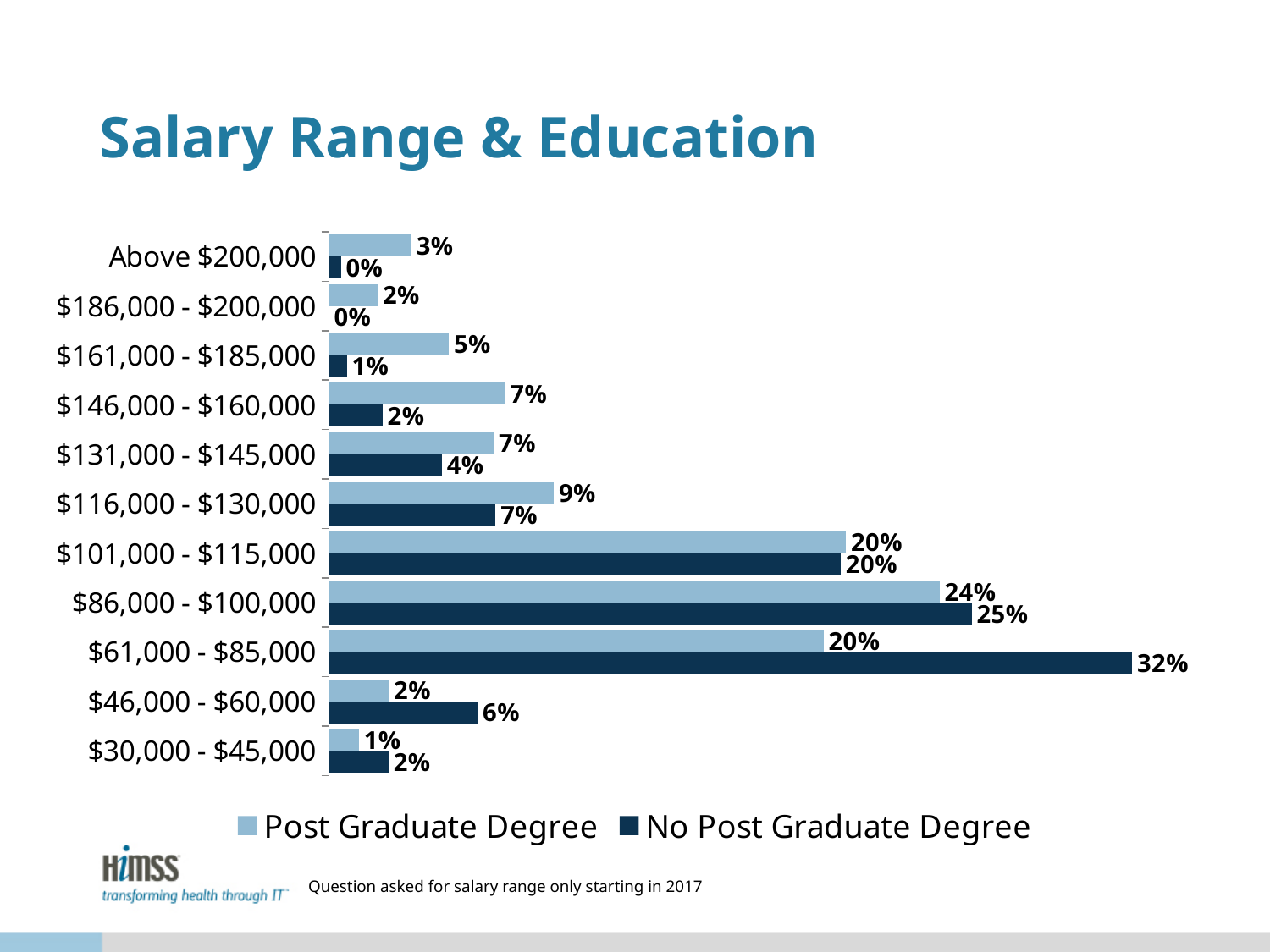
How many salary range categories are shown on the chart? 11 Which salary range has the highest value for No Post Graduate Degree? $61,000 - $85,000 What is the value for No Post Graduate Degree in the $46,000 - $60,000 salary range? 6% In the $146,000 - $160,000 range, which series has the larger value: Post Graduate Degree or No Post Graduate Degree? Post Graduate Degree What is the value for Post Graduate Degree in the $116,000 - $130,000 salary range? 9% What type of chart is shown on the slide? Bar chart How many series does the legend list? 2 What percentage of respondents with a Post Graduate Degree earn $61,000 - $85,000? 20% Which salary range has the highest value for Post Graduate Degree? $86,000 - $100,000 What percentage of respondents with No Post Graduate Degree earn $61,000 - $85,000? 32% What is the title of the chart on the slide? Salary Range & Education What is the difference between the No Post Graduate Degree and Post Graduate Degree values in the $61,000 - $85,000 range? 12%